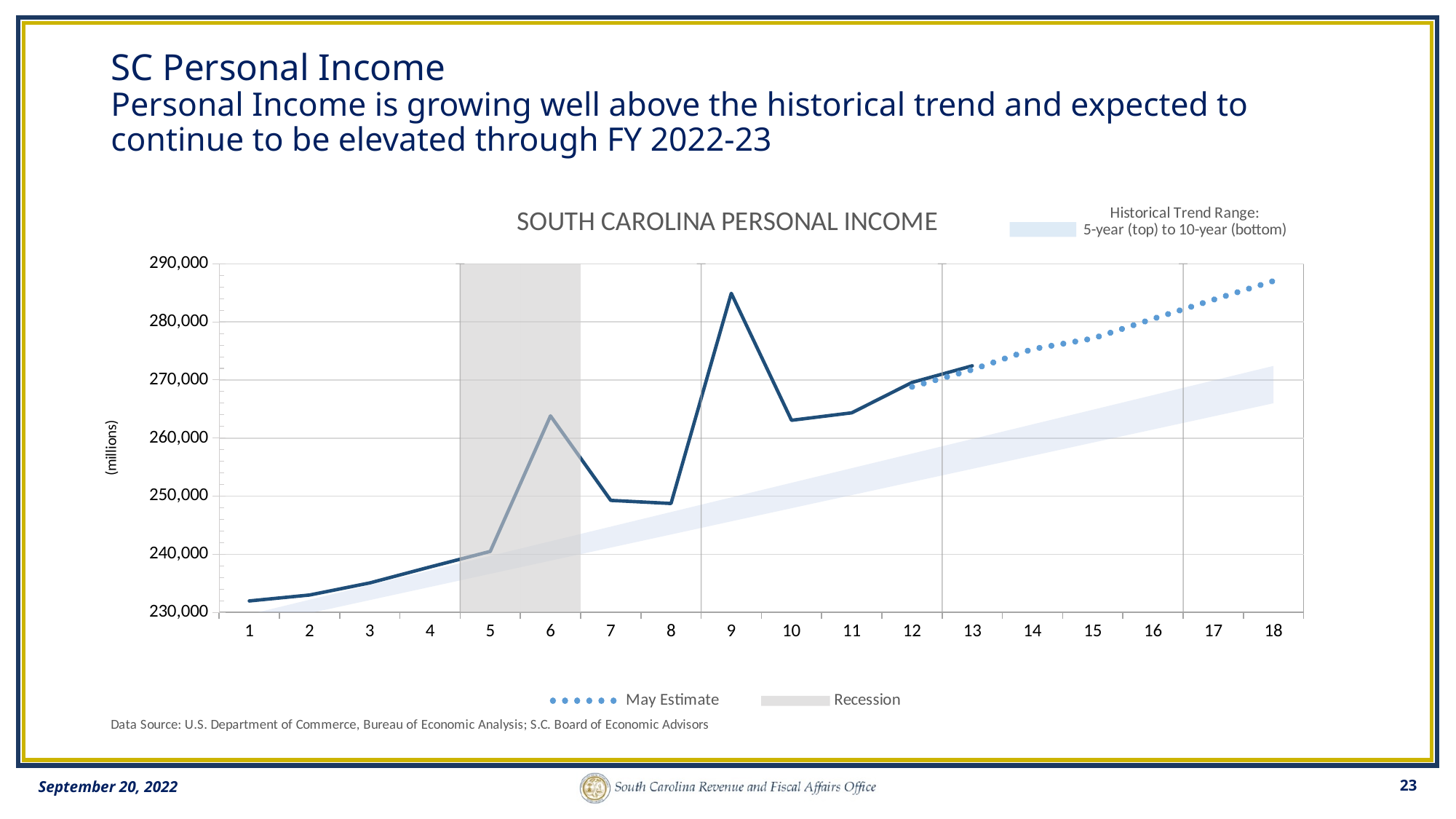
How many periods are labelled along the x axis of the chart? 18 Which period has the higher personal income value, period 9 or period 6? period 9 Is the personal income value at period 10 greater or less than 260,000? greater Is the personal income value at period 3 greater or less than 240,000? less How many entries does the legend at the bottom of the chart list? 2 At which x-axis period does the solid personal income line reach its highest value? 9 Is the May Estimate value at period 18 greater or less than 280,000? greater What is the title of the chart? SOUTH CAROLINA PERSONAL INCOME At which x-axis period is the solid personal income line at its lowest value? 1 What kind of chart is shown on the slide? line chart Does the May Estimate dotted line rise or fall from period 12 to period 18? rise